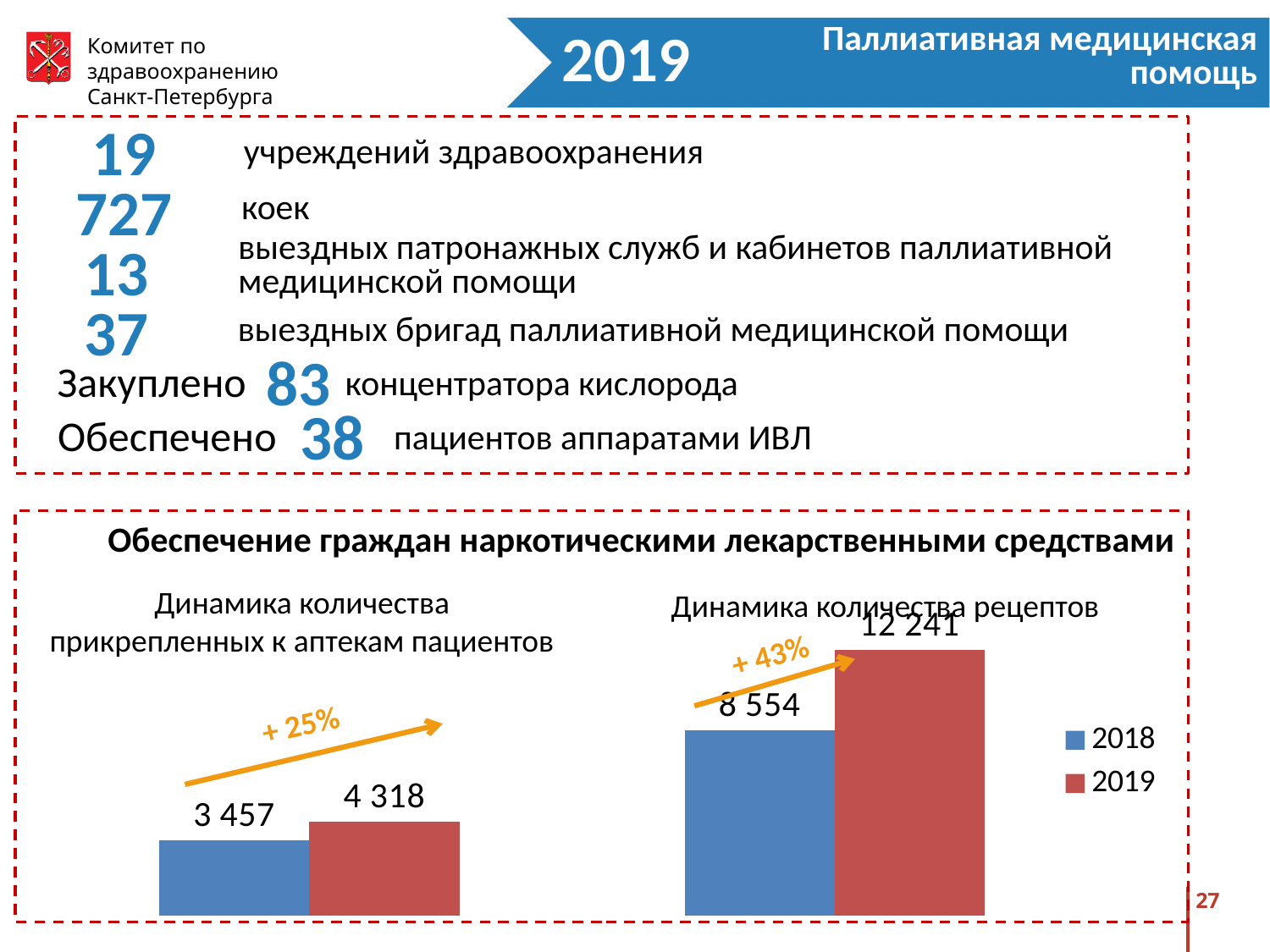
In the chart 'Динамика количества прикрепленных к аптекам пациентов', what is the value for 2019? 4 318 In the chart 'Динамика количества рецептов', what is the value for 2018? 8 554 What type of chart is 'Динамика количества рецептов'? Bar chart In the chart 'Динамика количества рецептов', what is the value for 2019? 12 241 In the chart 'Динамика количества прикрепленных к аптекам пациентов', what is the difference between the 2019 and 2018 values? 861 In the chart 'Динамика количества прикрепленных к аптекам пациентов', what is the value for 2018? 3 457 In the chart 'Динамика количества рецептов', what is the difference between the 2019 and 2018 values? 3 687 In the chart 'Динамика количества прикрепленных к аптекам пациентов', do the values rise or fall from 2018 to 2019? Rise What percentage increase is shown by the arrow on the chart 'Динамика количества рецептов'? + 43% In the chart 'Динамика количества рецептов', which year has the higher value? 2019 How many series does the legend on the slide list? 2 In the chart 'Динамика количества прикрепленных к аптекам пациентов', which year has the lower value? 2018